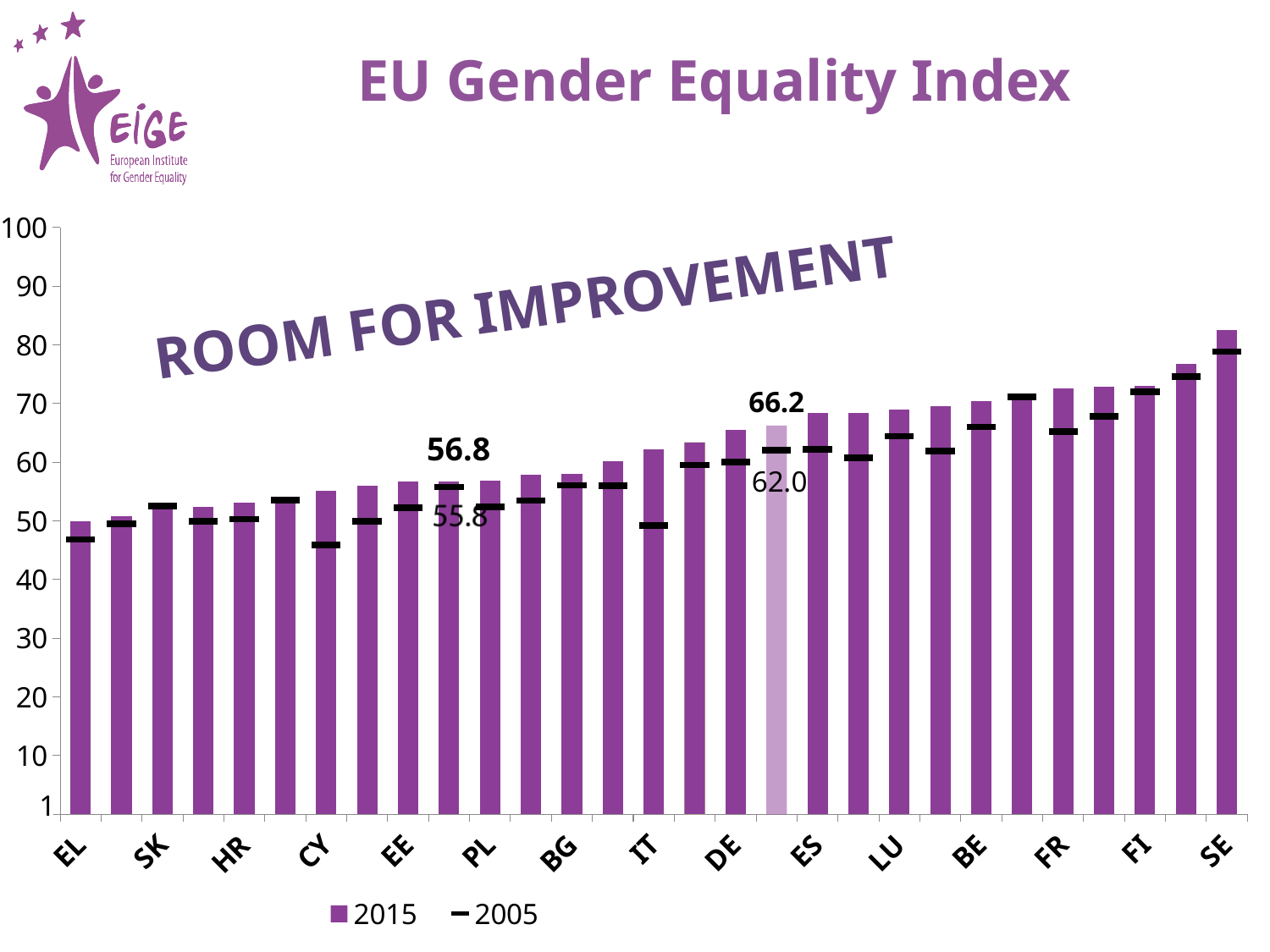
Which labelled country has the lowest 2015 value? EL Do the 2015 values generally rise or fall from left to right along the x axis? rise What is the difference between the 2015 and 2005 values for the lighter-coloured bar between DE and ES? 4.2 Is the 2005 value for CY greater or less than 50? less Is the 2015 value for SE greater or less than 80? greater Which labelled country has the highest 2015 value? SE What is the 2015 value shown on the lighter-coloured bar between DE and ES? 66.2 How many series does the legend list? 2 What is the 2015 value for PL? 56.8 What is the 2005 value shown for the lighter-coloured bar between DE and ES? 62.0